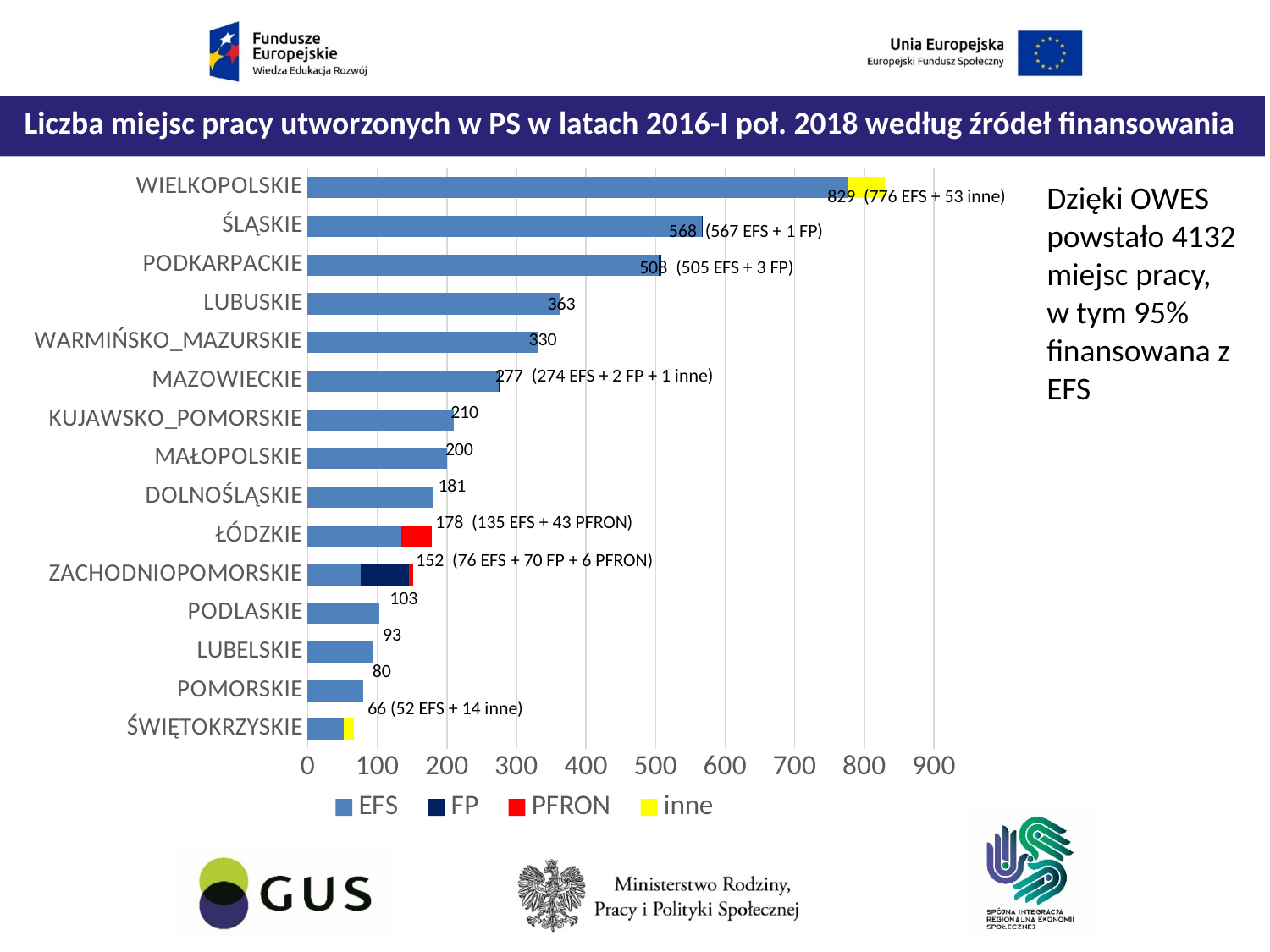
How many voivodeships are shown on the chart? 15 How many jobs were financed by EFS in ŁÓDZKIE? 135 Which voivodeship has the lowest total value? ŚWIĘTOKRZYSKIE How many series does the legend list? 4 How many jobs were financed by FP in ZACHODNIOPOMORSKIE? 70 What is the total number of jobs shown for WIELKOPOLSKIE? 829 Is the total for MAZOWIECKIE greater or less than 300? less What is the difference between the totals for ŚLĄSKIE and PODKARPACKIE? 60 Which has a larger total, LUBUSKIE or WARMIŃSKO_MAZURSKIE? LUBUSKIE Which colour represents the 'inne' series in the legend? Yellow What kind of chart is shown on the slide? Stacked bar chart Which voivodeship has the highest total value? WIELKOPOLSKIE